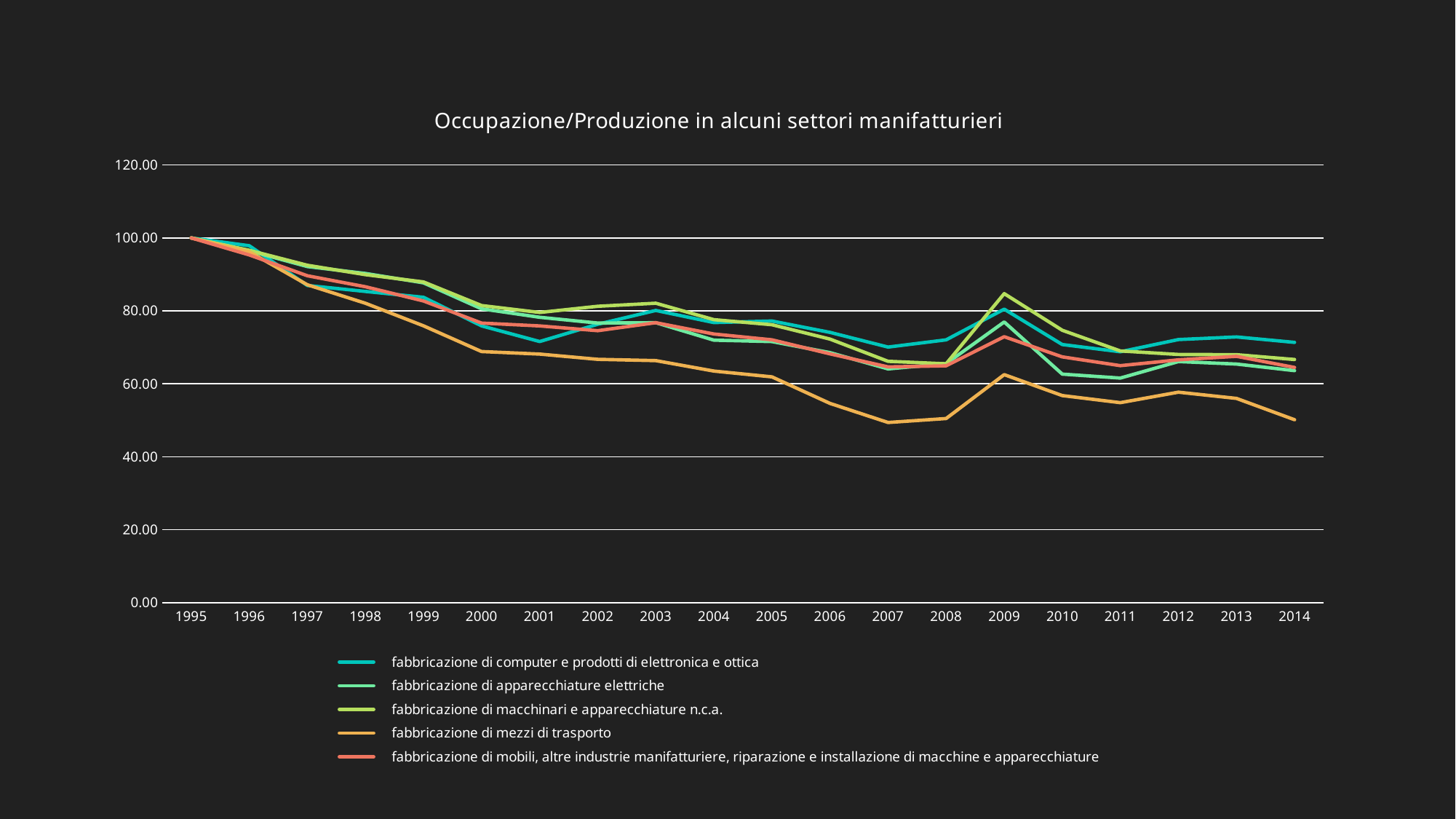
Which series has the highest value in 2009? fabbricazione di macchinari e apparecchiature n.c.a. What type of chart is shown on the slide? line chart Is the value for fabbricazione di mezzi di trasporto in 2014 greater or less than 60.00? less Which series has the lowest value in 2014? fabbricazione di mezzi di trasporto In 2009, which is larger: fabbricazione di macchinari e apparecchiature n.c.a. or fabbricazione di mezzi di trasporto? fabbricazione di macchinari e apparecchiature n.c.a. Is the value for fabbricazione di computer e prodotti di elettronica e ottica in 2014 greater or less than 80.00? less How many years are shown along the x axis? 20 What value do all the series share in 1995? 100.00 Does the value for fabbricazione di mezzi di trasporto rise or fall overall from 1995 to 2014? fall Is the value for fabbricazione di macchinari e apparecchiature n.c.a. in 2009 greater or less than 80.00? greater How many series does the legend list? 5